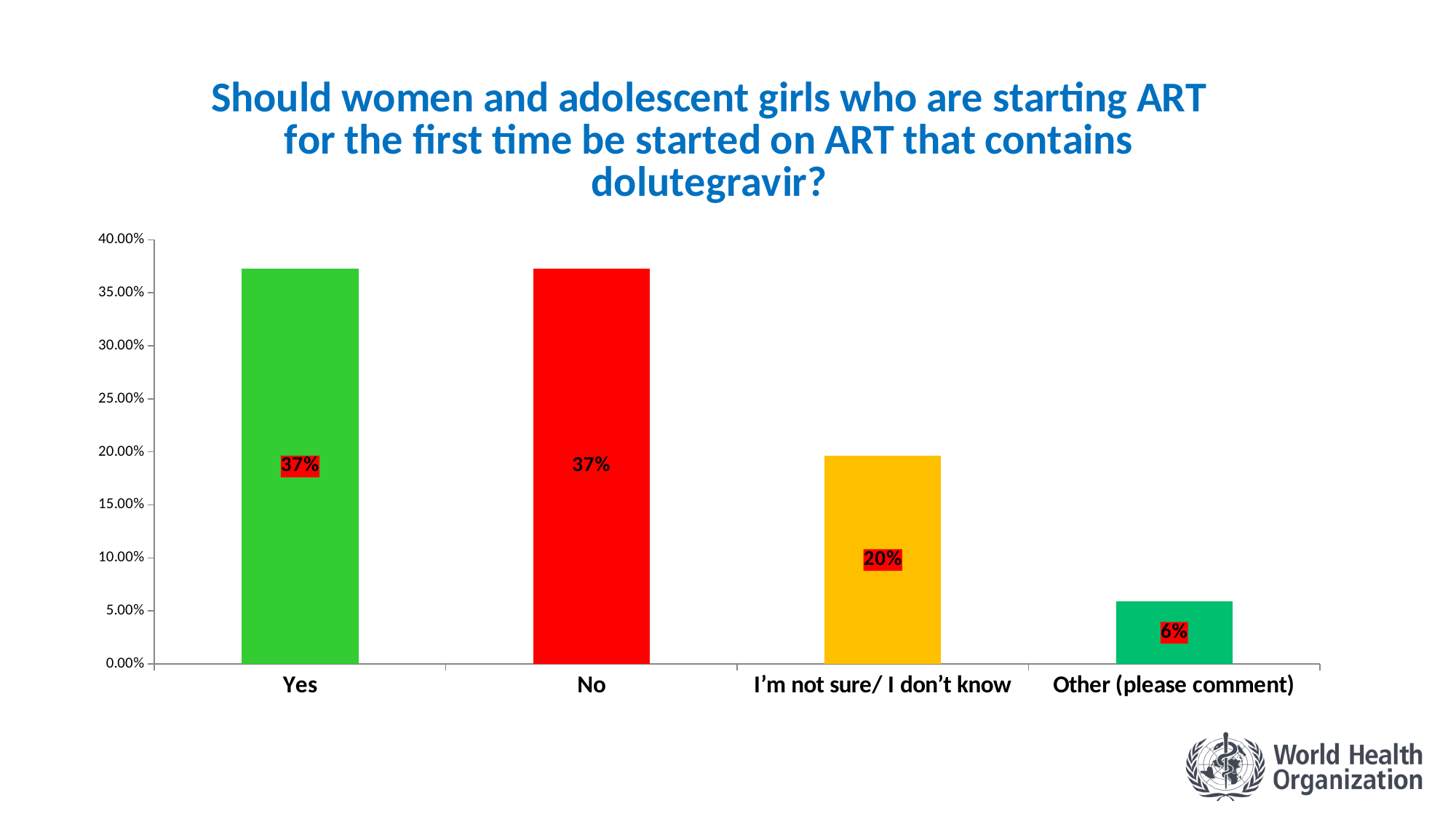
What is the difference between the values for "Yes" and "I'm not sure/ I don't know"? 17% What is the value for "Other (please comment)"? 6% Which category has the lowest value? Other (please comment) Which is larger, the value for "No" or the value for "I'm not sure/ I don't know"? No What is the value for "No"? 37% How many categories are shown on the chart? 4 What is the value for "I'm not sure/ I don't know"? 20% What is the value for "Yes"? 37% What is the difference between the values for "I'm not sure/ I don't know" and "Other (please comment)"? 14% Is the value for "Other (please comment)" greater or less than 10.00%? less What kind of chart is shown on the slide? Bar chart Is the value for "Yes" greater or less than 30.00%? greater